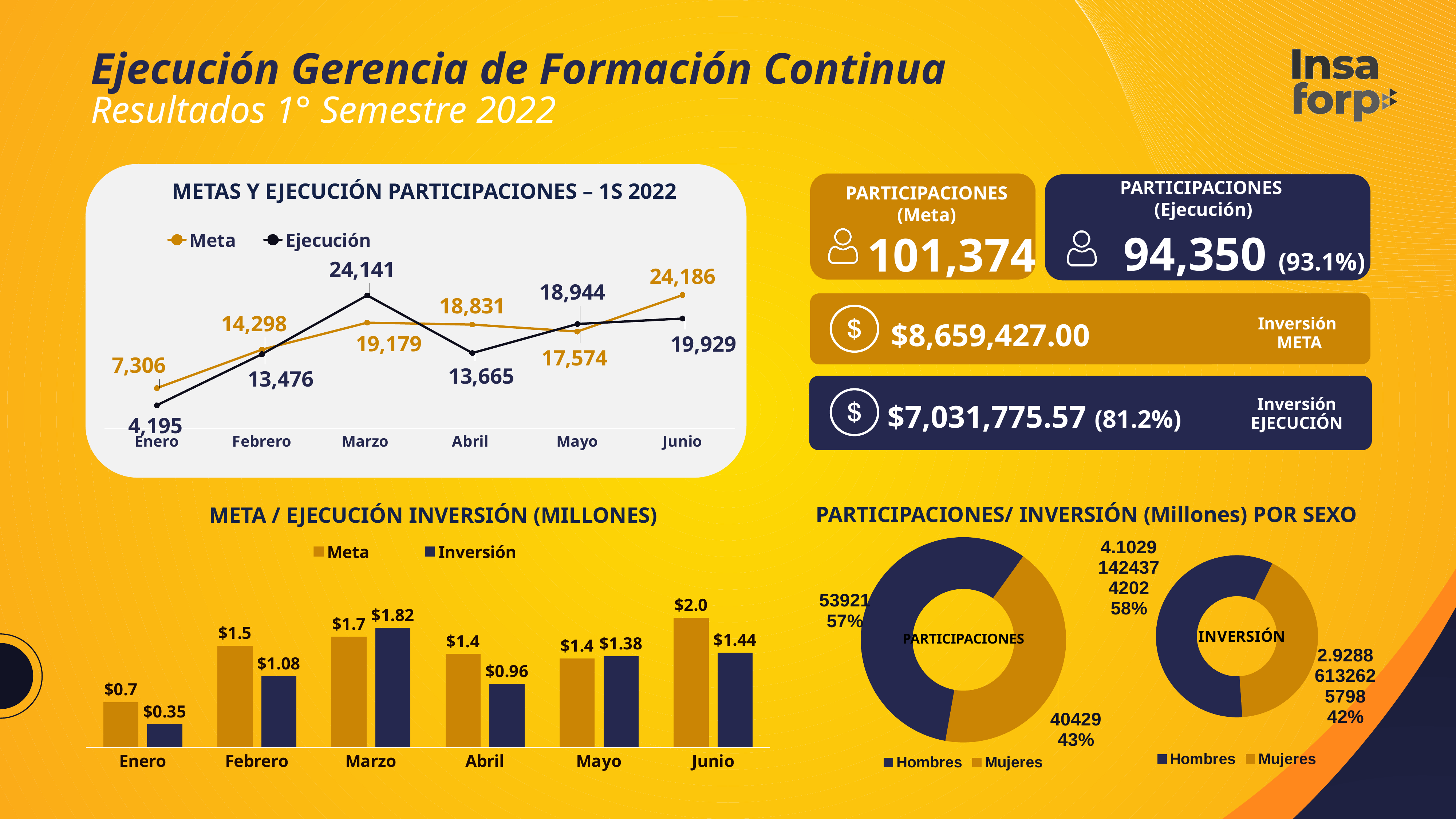
In the line chart 'METAS Y EJECUCIÓN PARTICIPACIONES – 1S 2022', which is larger for Abril, Meta or Ejecución? Meta In the line chart 'METAS Y EJECUCIÓN PARTICIPACIONES – 1S 2022', what is the difference between the Meta and Ejecución values for Enero? 3,111 In the bar chart 'META / EJECUCIÓN INVERSIÓN (MILLONES)', what is the difference between the Meta and Inversión values for Junio? $0.56 In the bar chart 'META / EJECUCIÓN INVERSIÓN (MILLONES)', which month has the highest Meta value? Junio In the 'PARTICIPACIONES' donut chart, what share of the total is Hombres? 57% In the 'INVERSIÓN' donut chart, what share of the total is Mujeres? 42% In the line chart 'METAS Y EJECUCIÓN PARTICIPACIONES – 1S 2022', which month has the lowest Ejecución value? Enero How many months are shown on the x axis of the bar chart 'META / EJECUCIÓN INVERSIÓN (MILLONES)'? 6 In the line chart 'METAS Y EJECUCIÓN PARTICIPACIONES – 1S 2022', what is the Ejecución value for Marzo? 24,141 In the line chart 'METAS Y EJECUCIÓN PARTICIPACIONES – 1S 2022', what is the Meta value for Junio? 24,186 How many series does the legend of the line chart 'METAS Y EJECUCIÓN PARTICIPACIONES – 1S 2022' list? 2 In the bar chart 'META / EJECUCIÓN INVERSIÓN (MILLONES)', what is the Inversión value for Febrero? $1.08